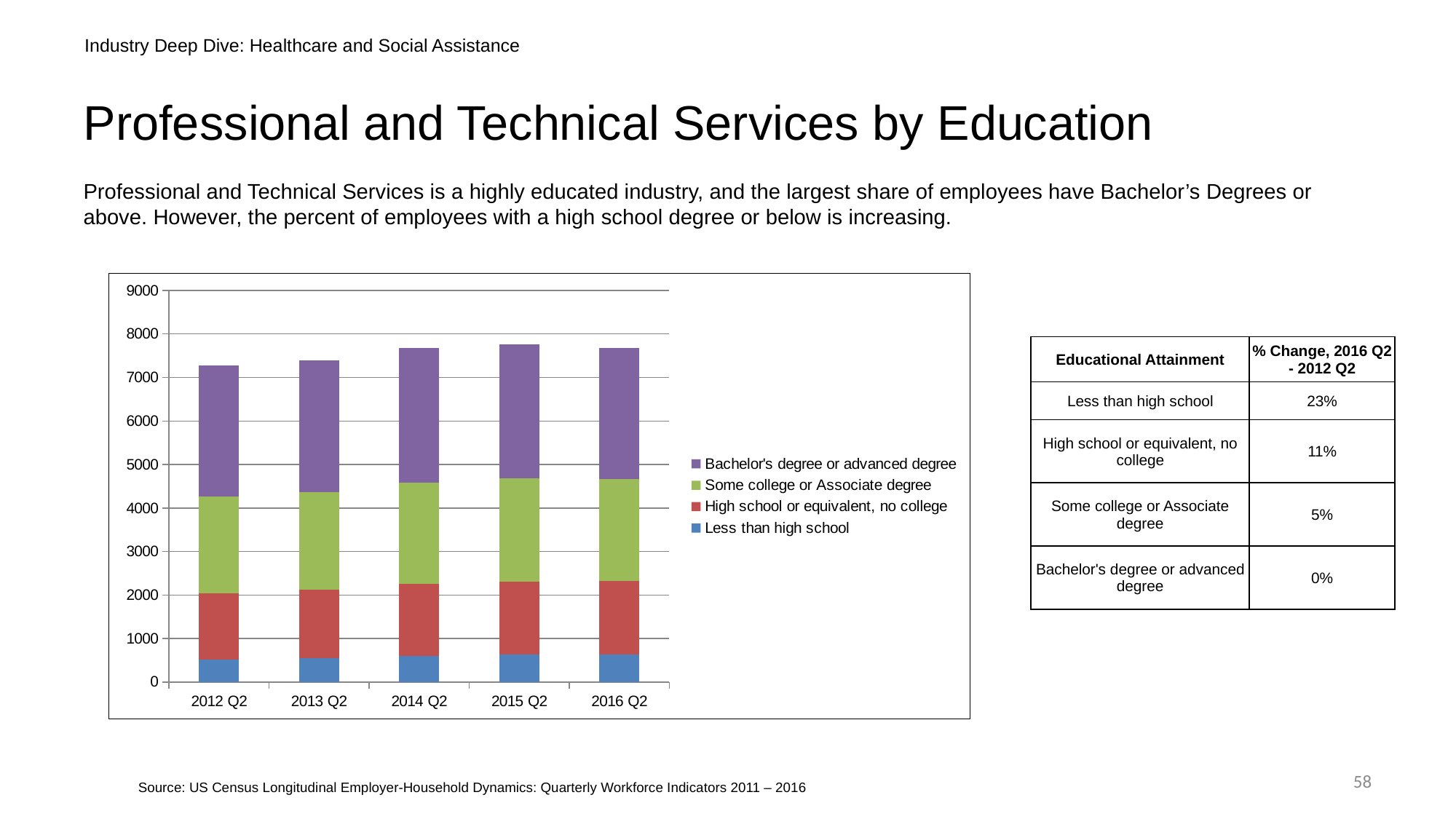
Is the total height of the 2012 Q2 bar greater or less than 7000? greater Which series is listed first in the chart's legend? Bachelor's degree or advanced degree How many quarters are shown on the x axis of the chart? 5 What kind of chart is shown on the slide? stacked bar chart Which series is shown in blue at the bottom of each stacked bar? Less than high school Do the total bar heights rise or fall from 2012 Q2 to 2014 Q2? rise Is the Less than high school segment larger in 2012 Q2 or in 2016 Q2? 2016 Q2 Is the Less than high school segment for 2016 Q2 greater or less than 1000? less How many series does the chart's legend list? 4 In 2012 Q2, which segment is larger: Bachelor's degree or advanced degree, or Some college or Associate degree? Bachelor's degree or advanced degree Is the total height of the 2015 Q2 bar greater or less than 8000? less Which quarter has the lowest total bar height? 2012 Q2